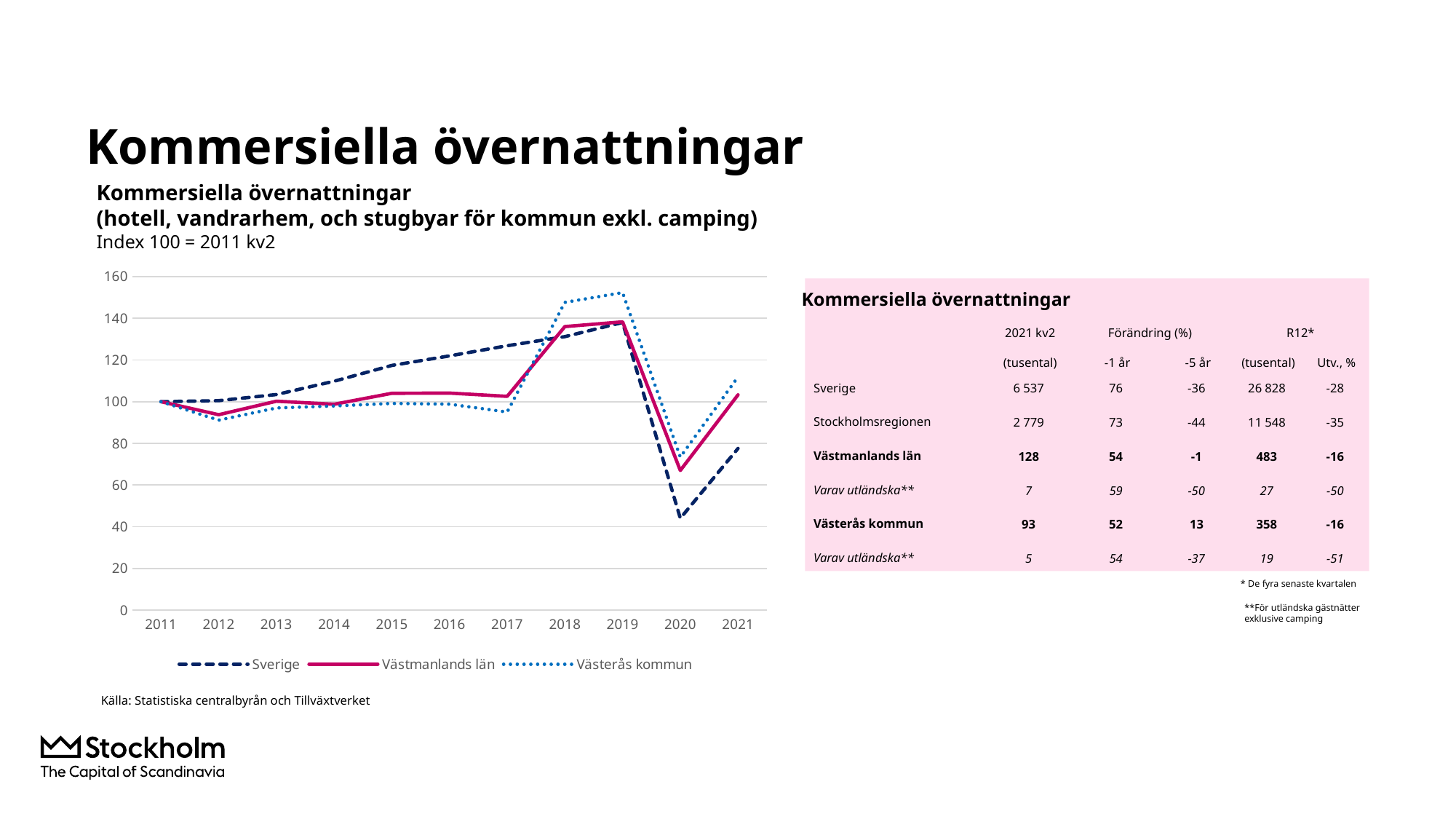
Is the value for Västerås kommun in 2019 greater or less than 140? greater How many years are shown on the x axis of the chart? 11 How many series does the chart legend list? 3 What is the index value for Sverige in 2011? 100 Which series is drawn with a solid pink line in the chart? Västmanlands län Is the value for Sverige in 2020 greater or less than 60? less Is the value for Västmanlands län in 2020 greater or less than 80? less Which series has the highest value in 2019? Västerås kommun In 2016, which is larger: the value for Sverige or the value for Västmanlands län? Sverige Which series has the lowest value in 2020? Sverige What kind of chart is shown on the slide? line chart Does the Sverige line rise or fall between 2011 and 2019? rise